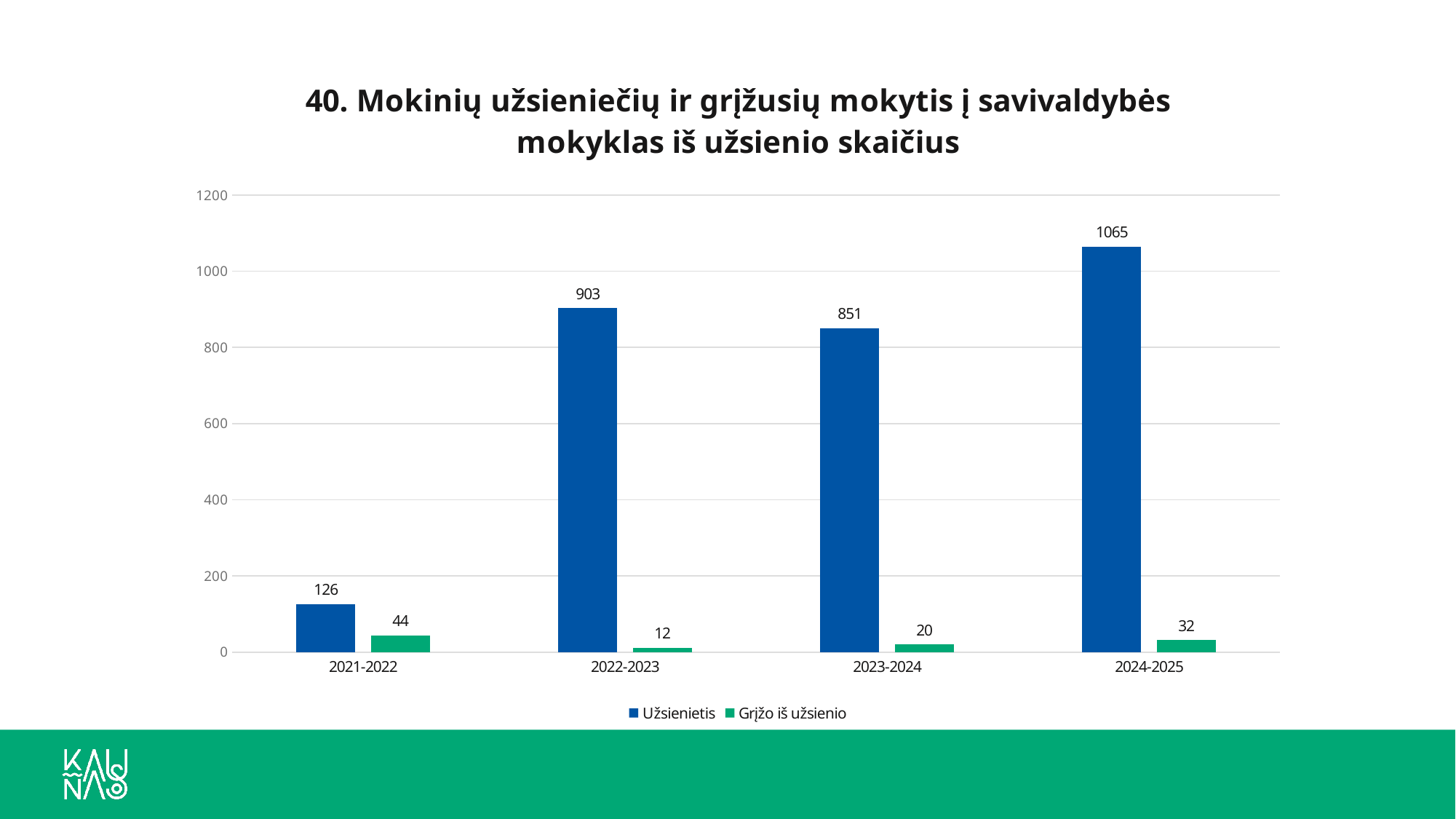
Which colour represents the Grįžo iš užsienio series? green How many school years are shown on the x axis? 4 What is the value for Užsienietis in 2022-2023? 903 Is the value for Užsienietis in 2021-2022 greater or less than 200? less What is the value for Užsienietis in 2024-2025? 1065 Which school year has the lowest value for Grįžo iš užsienio? 2022-2023 Which school year has the highest value for Užsienietis? 2024-2025 How many series does the legend list? 2 What is the value for Grįžo iš užsienio in 2021-2022? 44 What kind of chart is shown on the slide? bar chart Which is larger: the Užsienietis value for 2022-2023 or for 2023-2024? 2022-2023 What is the difference between the Užsienietis values for 2024-2025 and 2023-2024? 214